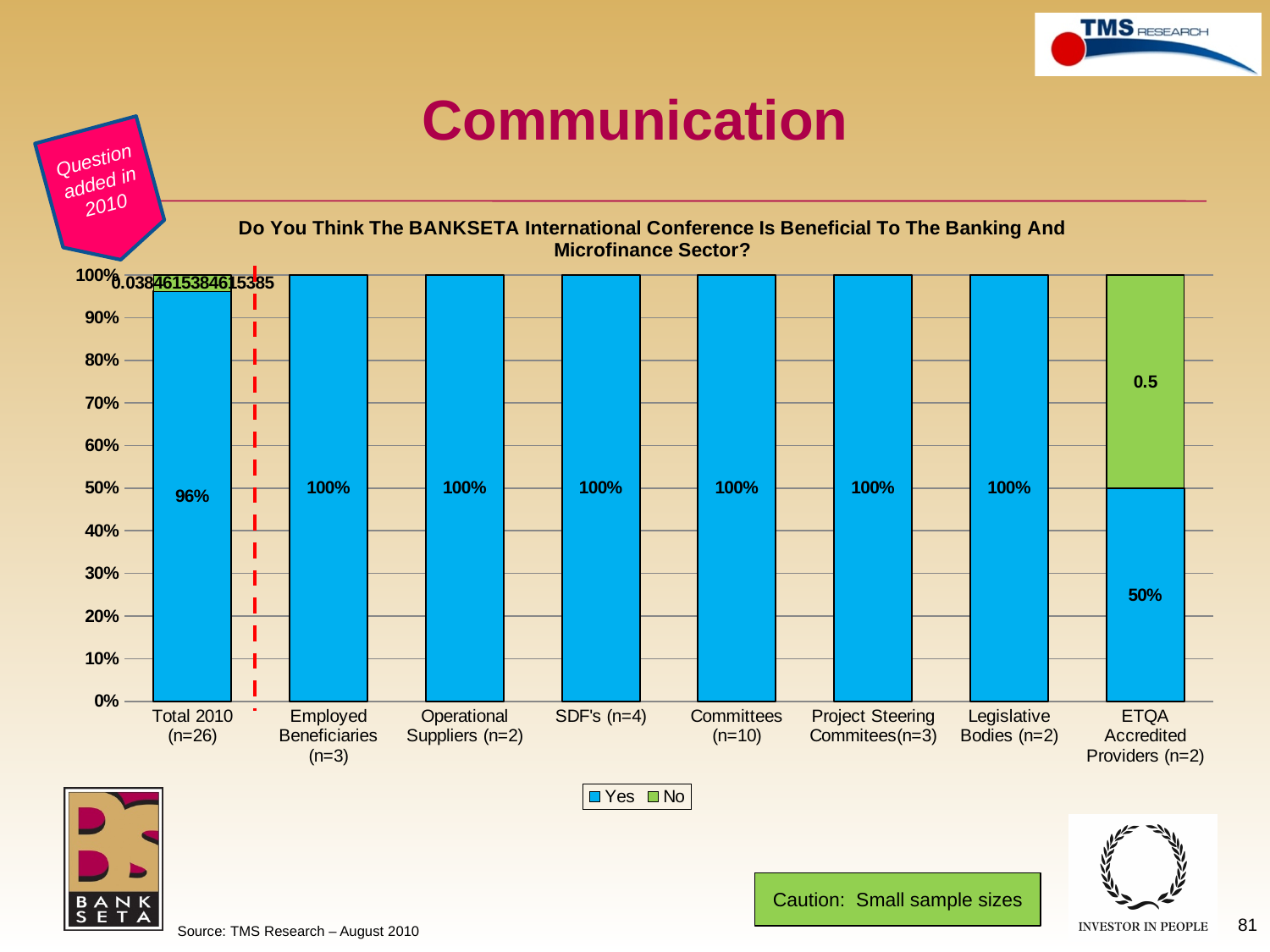
What is the difference between the Yes value for Committees (n=10) and the Yes value for ETQA Accredited Providers (n=2)? 50% How many series does the legend list? 2 What is the No value shown for ETQA Accredited Providers (n=2)? 0.5 Which category has the lowest Yes value? ETQA Accredited Providers (n=2) What kind of chart is shown on the slide? Stacked bar chart What is the Yes value for ETQA Accredited Providers (n=2)? 50% What is the title of the chart? Do You Think The BANKSETA International Conference Is Beneficial To The Banking And Microfinance Sector? What is the Yes value for Total 2010 (n=26)? 96% How many categories are shown on the x axis? 8 Which is larger, the Yes value for Total 2010 (n=26) or the Yes value for ETQA Accredited Providers (n=2)? Total 2010 (n=26) Is the Yes value for ETQA Accredited Providers (n=2) greater or less than 70%? less What is the Yes value for Committees (n=10)? 100%